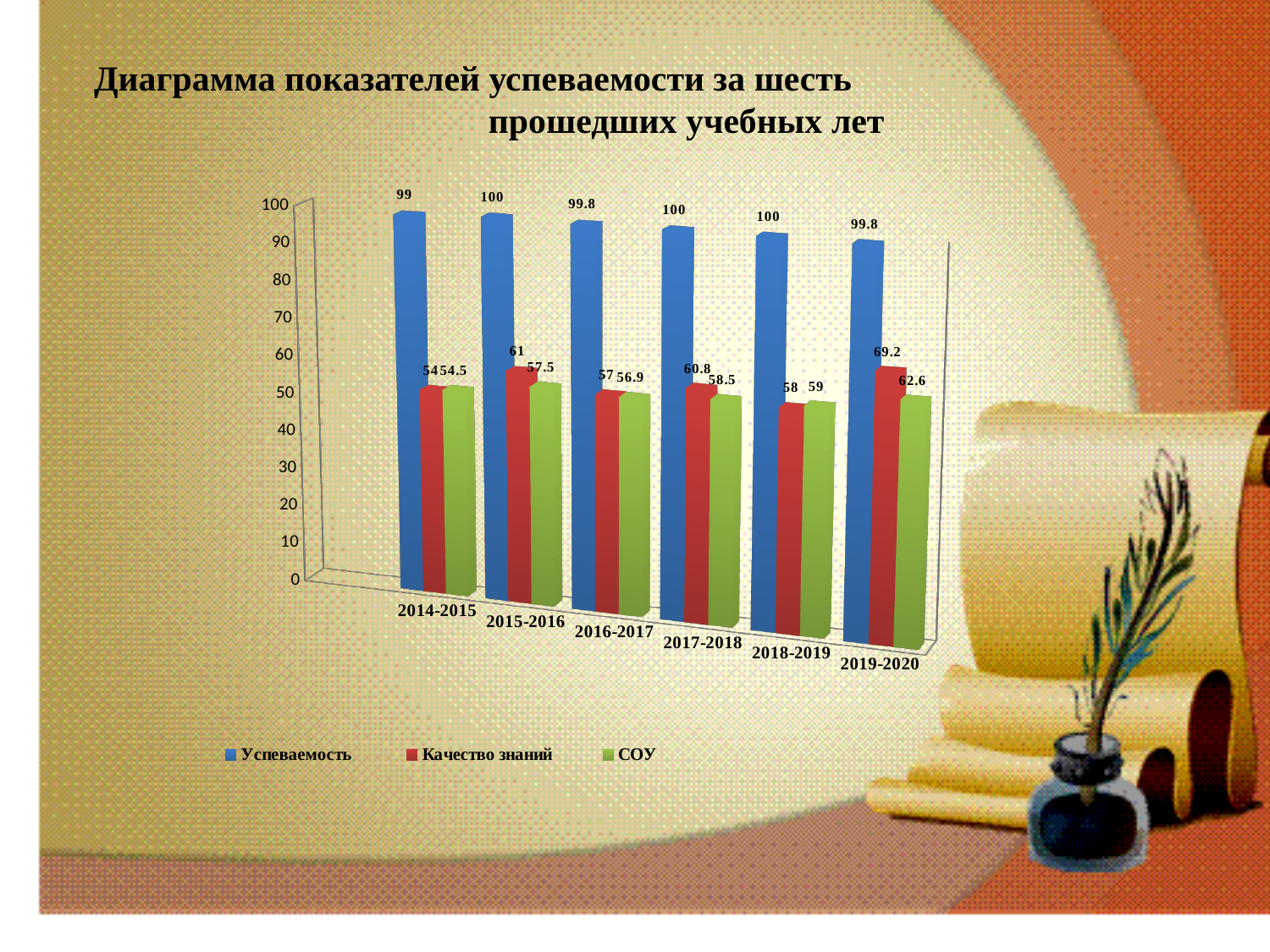
What is the value of Качество знаний for 2019-2020? 69.2 What is the value of СОУ for 2014-2015? 54.5 Which colour represents СОУ in the legend? Green What is the value of Качество знаний for 2017-2018? 60.8 What is the value of Успеваемость for 2016-2017? 99.8 How many series does the legend list? 3 What kind of chart is shown on the slide? Bar chart What is the difference between Качество знаний in 2019-2020 and in 2014-2015? 15.2 Which is larger for 2018-2019: Качество знаний or СОУ? СОУ In which year is СОУ lowest? 2014-2015 How many academic years are shown on the x axis? 6 In which year is Качество знаний highest? 2019-2020